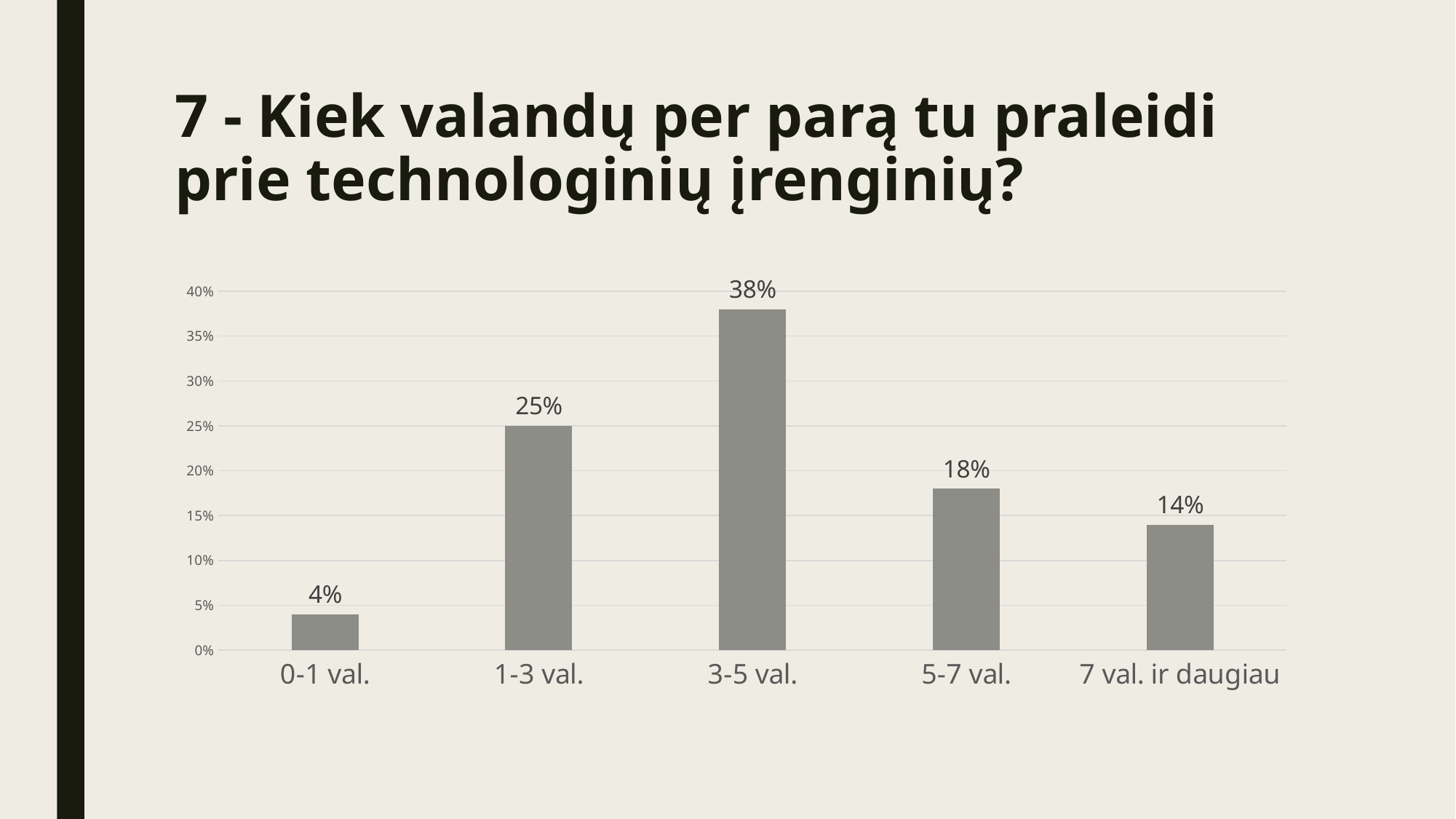
Which category has the highest value? 3-5 val. What is the title of the slide? 7 - Kiek valandų per parą tu praleidi prie technologinių įrenginių? Which category has the lowest value? 0-1 val. What is the difference between the values for 5-7 val. and 7 val. ir daugiau? 4% What is the value for 0-1 val.? 4% What is the value for 7 val. ir daugiau? 14% What is the difference between the values for 3-5 val. and 1-3 val.? 13% Is the value for 5-7 val. greater or less than 20%? less What kind of chart is shown on the slide? bar chart How many categories are shown on the x axis? 5 What is the value for 3-5 val.? 38% Which is larger, the value for 1-3 val. or the value for 5-7 val.? 1-3 val.